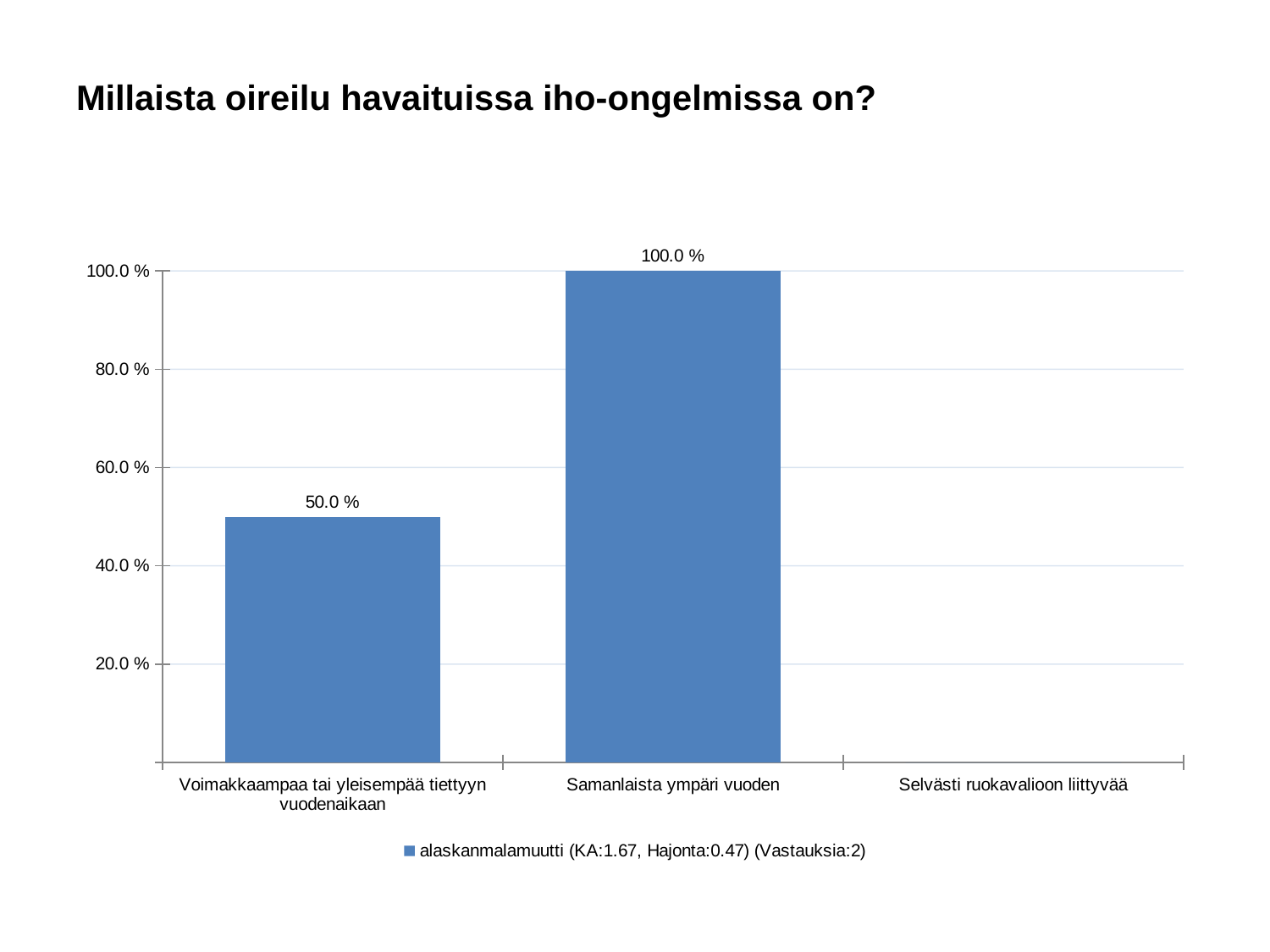
What kind of chart is shown on the slide? bar chart How many series does the legend list? 1 What is the title of the slide? Millaista oireilu havaituissa iho-ongelmissa on? What is the value for "Voimakkaampaa tai yleisempää tiettyyn vuodenaikaan"? 50.0 % Which is larger, the value for "Voimakkaampaa tai yleisempää tiettyyn vuodenaikaan" or the value for "Samanlaista ympäri vuoden"? Samanlaista ympäri vuoden Which category has the highest value? Samanlaista ympäri vuoden What is the value for "Samanlaista ympäri vuoden"? 100.0 % How many categories are shown on the x axis? 3 Is the value for "Voimakkaampaa tai yleisempää tiettyyn vuodenaikaan" greater or less than 60.0 %? less Which category has no visible bar? Selvästi ruokavalioon liittyvää What is the difference between the values for "Samanlaista ympäri vuoden" and "Voimakkaampaa tai yleisempää tiettyyn vuodenaikaan"? 50.0 % What is the legend entry for the series? alaskanmalamuutti (KA:1.67, Hajonta:0.47) (Vastauksia:2)